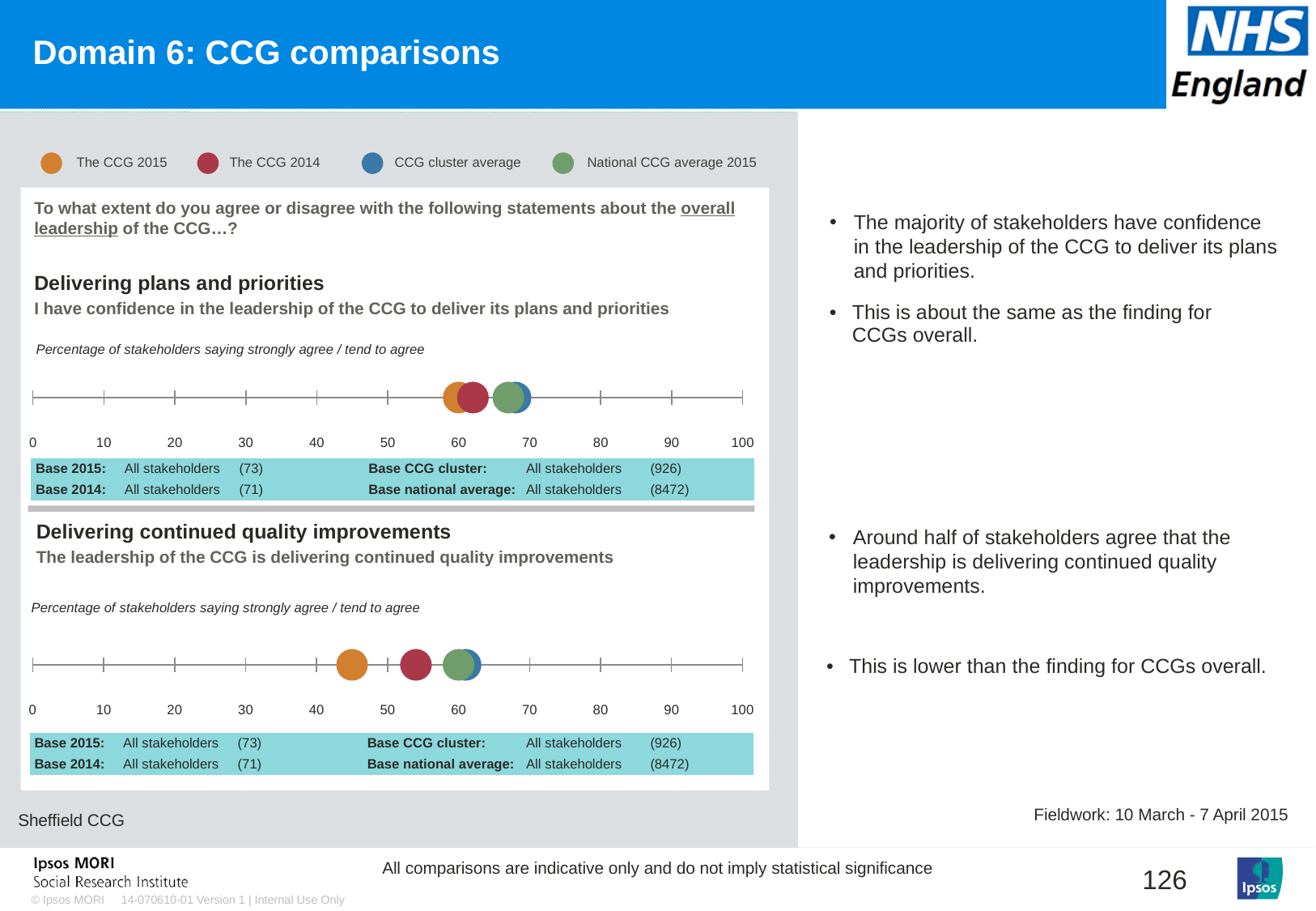
How many tick labels are shown along the x axis of the 'Delivering continued quality improvements' chart? 11 In the 'Delivering continued quality improvements' chart, which is larger: The CCG 2015 or The CCG 2014? The CCG 2014 In the 'Delivering continued quality improvements' chart, is the value for The CCG 2014 greater or less than 50? greater In the 'Delivering plans and priorities' chart, is the value for The CCG 2015 greater or less than 70? less In the 'Delivering continued quality improvements' chart, is the value for the CCG cluster average greater or less than 50? greater How many series does the legend at the top of the slide list? 4 Which colour represents the National CCG average 2015 in the legend? Green In the 'Delivering continued quality improvements' chart, which series has the lowest value? The CCG 2015 What is the maximum value shown on the x axis of the 'Delivering plans and priorities' chart? 100